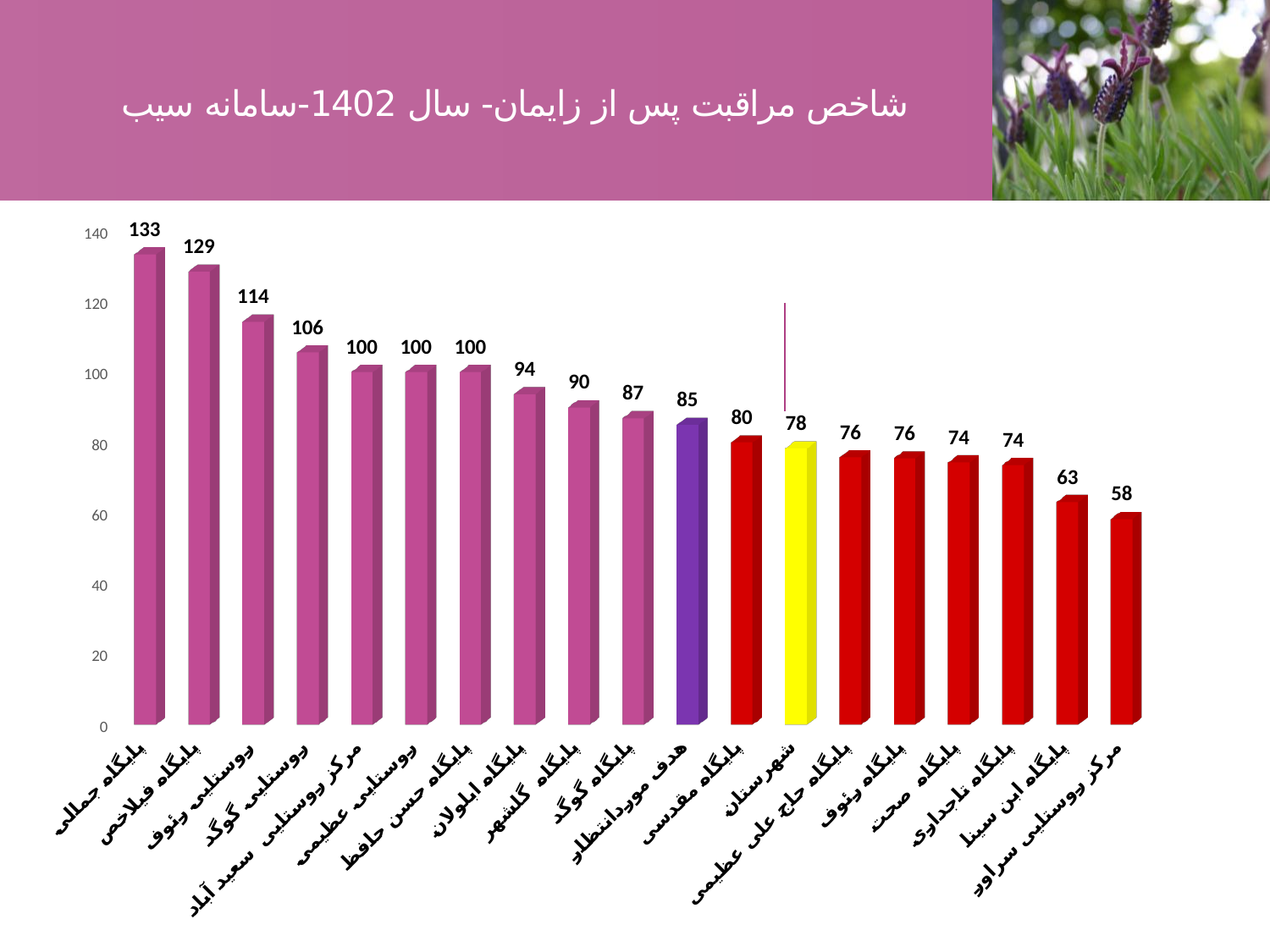
What is the value for پایگاه جمالی? 133 What is the difference between the values for پایگاه جمالی and پایگاه فیلاخص? 4 What is the difference between the values for هدف موردانتظار and شهرستان? 7 Do the values rise or fall from left to right along the x axis? fall What is the value for شهرستان? 78 Which category has the lowest value? مرکز روستایی سراور Which is larger, the value for پایگاه گلشهر or the value for پایگاه ابن سینا? پایگاه گلشهر What kind of chart is shown on the slide? bar chart How many bars are shown in the chart? 19 What is the value for هدف موردانتظار? 85 Which category has the highest value? پایگاه جمالی